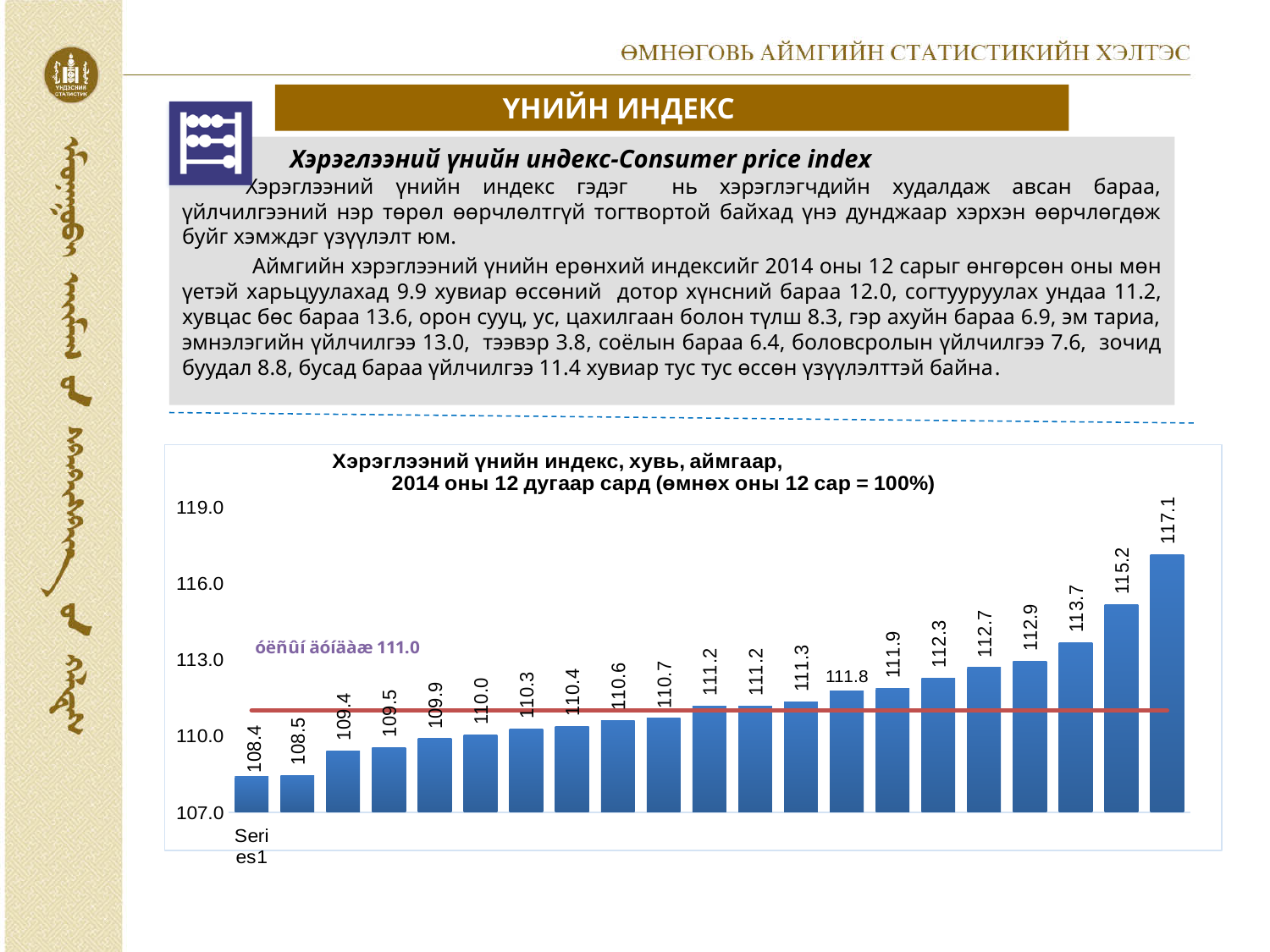
Is the value of the rightmost bar greater or less than 116.0? greater What is the difference between the tallest bar (117.1) and the shortest bar (108.4)? 8.7 What is the lowest value shown by any bar in the chart? 108.4 What kind of chart is shown on the slide? bar chart What value is marked by the horizontal red line across the chart? 111.0 What is the difference between the two tallest bars, 117.1 and 115.2? 1.9 Do the bar values rise or fall from left to right across the chart? rise What is the highest tick value shown on the vertical axis of the chart? 119.0 What is the value of the second bar from the right? 115.2 How many bars have values above 113.0? 3 What is the highest value shown by any bar in the chart? 117.1 How many bars are plotted in the chart? 21